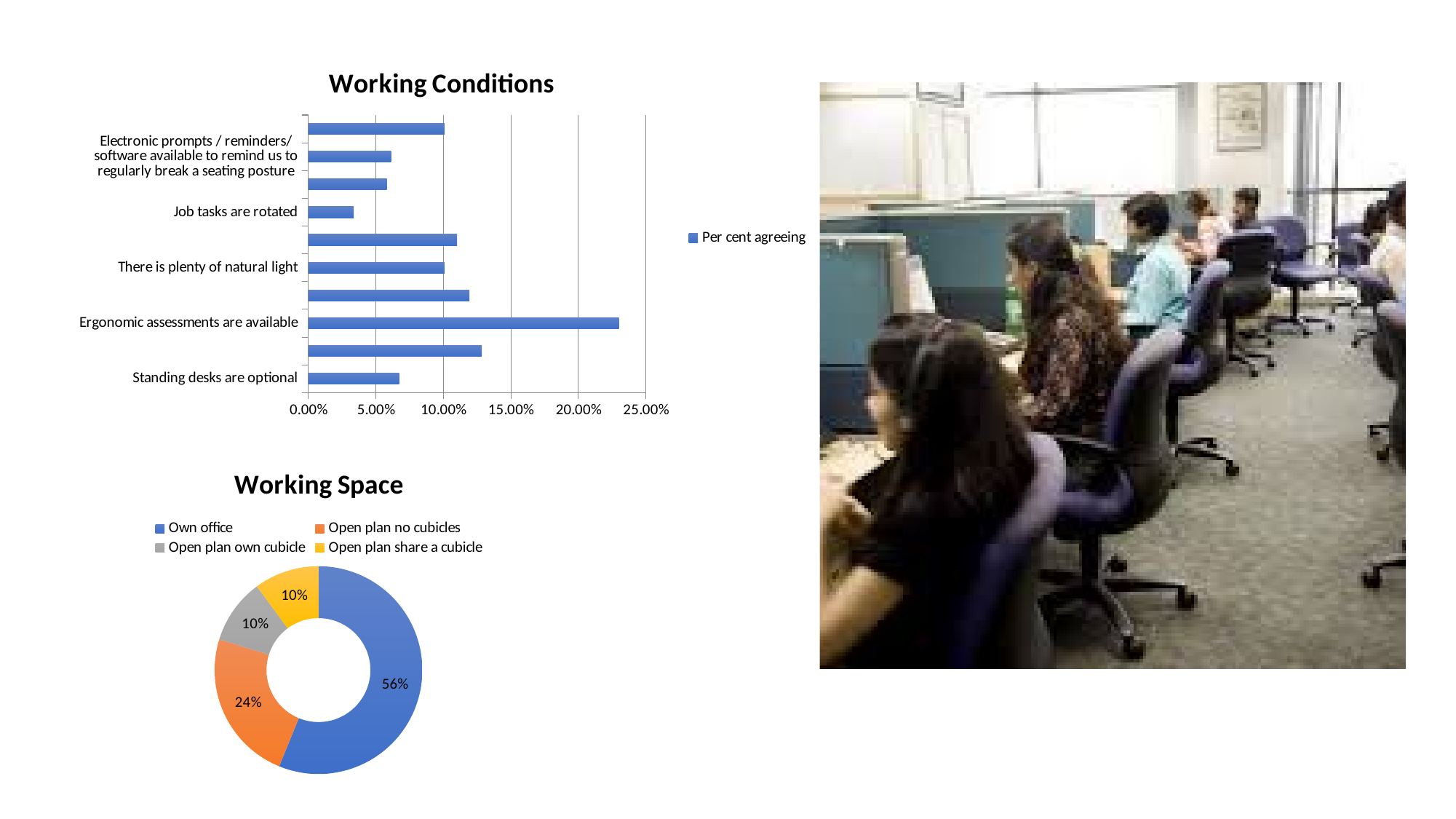
In the Working Space chart, what is the difference between the Own office share and the Open plan no cubicles share? 32% In the Working Conditions chart, which is larger: the value for There is plenty of natural light or the value for Job tasks are rotated? There is plenty of natural light In the Working Space chart, what share is Own office? 56% In the Working Conditions chart, which is larger: the value for Ergonomic assessments are available or the value for Standing desks are optional? Ergonomic assessments are available In the Working Conditions chart, which category has the highest value? Ergonomic assessments are available In the Working Conditions chart, is the value for Electronic prompts / reminders / software available to remind us to regularly break a seating posture greater or less than 10.00%? less How many categories does the Working Space chart show? 4 How many series does the legend of the Working Conditions chart list? 1 In the Working Conditions chart, is the value for Job tasks are rotated greater or less than 5.00%? less What kind of chart is the Working Conditions chart? Bar chart In the Working Conditions chart, which labelled category has the lowest value? Job tasks are rotated In the Working Conditions chart, is the value for Ergonomic assessments are available greater or less than 20.00%? greater